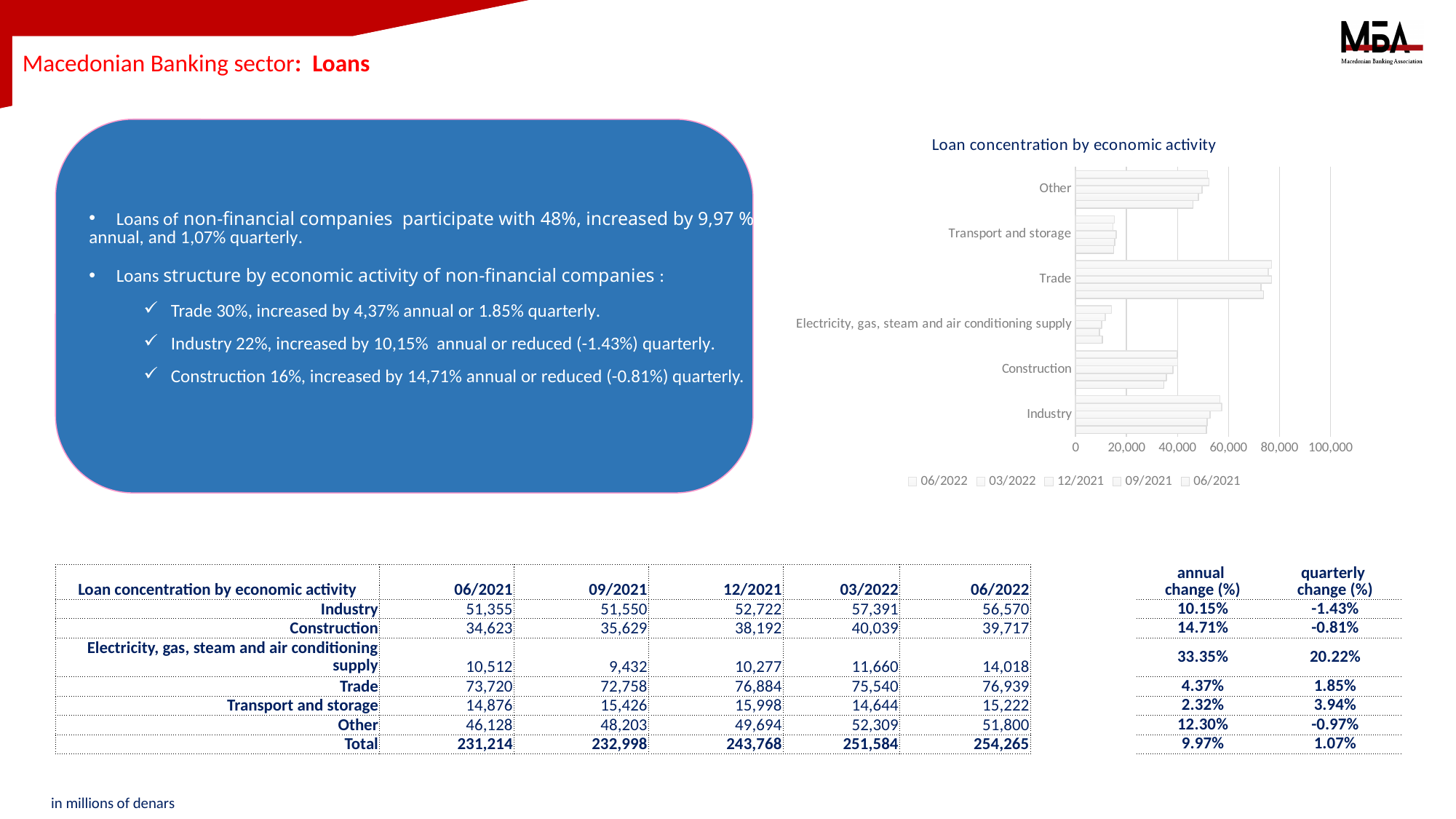
How many series does the chart legend list? 5 Which economic activity has the highest loan values on the chart? Trade Which period is listed first in the chart legend? 06/2022 Which has larger loan values on the chart, Other or Transport and storage? Other What kind of chart is shown on the slide? bar chart Are the values for Transport and storage greater or less than 20,000? less Are the values for Industry greater or less than 40,000? greater How many economic activity categories are shown on the chart? 6 Are the values for Trade greater or less than 60,000? greater Which has larger loan values on the chart, Industry or Construction? Industry What is the title of the chart? Loan concentration by economic activity